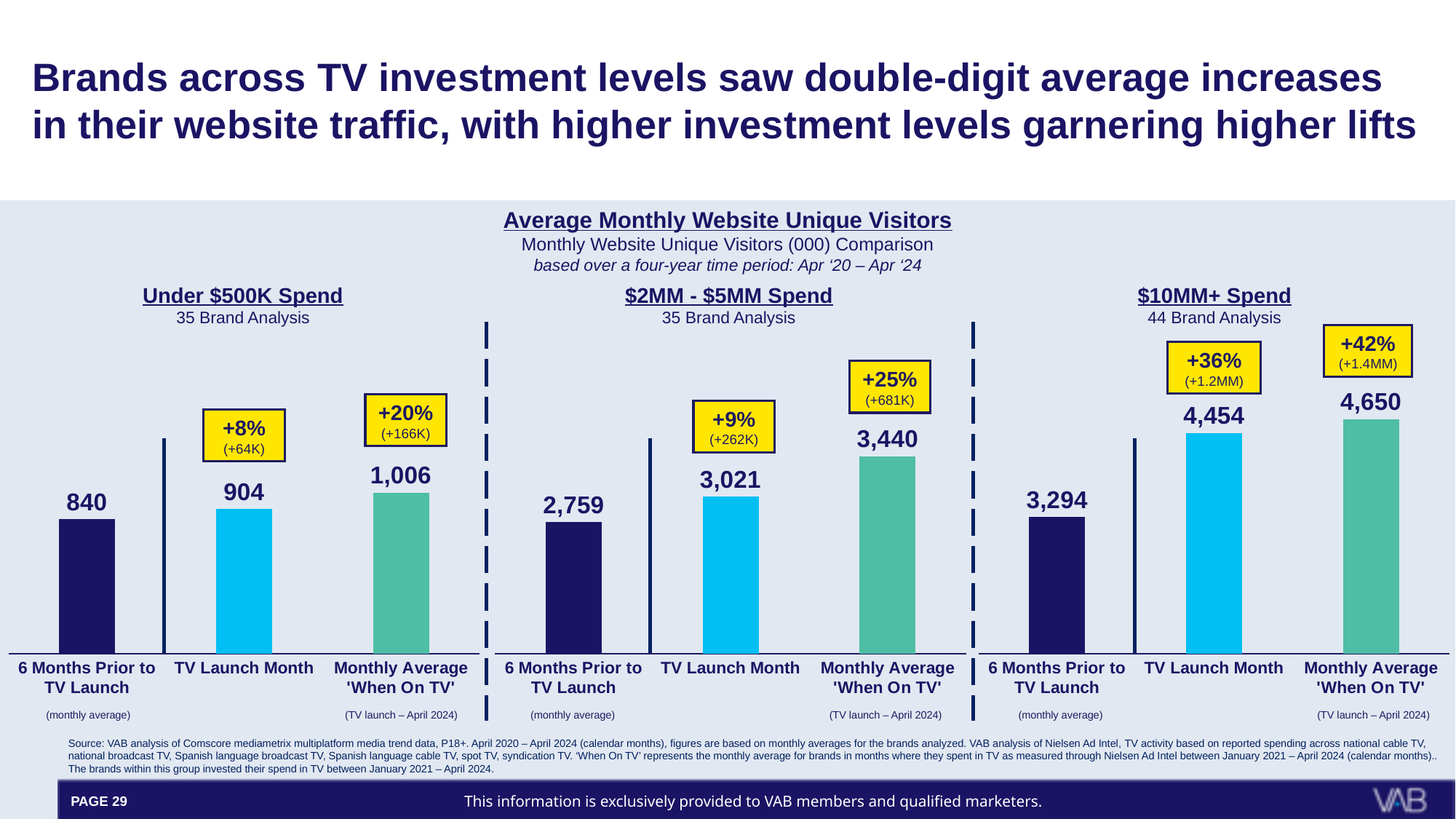
In the '$10MM+ Spend' chart, what is the difference between 'Monthly Average When On TV' and 'TV Launch Month'? 196 In the '$10MM+ Spend' chart, do the values rise or fall from left to right? Rise In the '$2MM - $5MM Spend' chart, what is the value for 'TV Launch Month'? 3,021 In the 'Under $500K Spend' chart, what is the value for '6 Months Prior to TV Launch'? 840 What type of chart is used for the 'Under $500K Spend' data? Bar chart In the 'Under $500K Spend' chart, what is the value for 'Monthly Average When On TV'? 1,006 In the '$2MM - $5MM Spend' chart, which category has the highest value? Monthly Average 'When On TV' In the '$10MM+ Spend' chart, what is the value for 'Monthly Average When On TV'? 4,650 In the 'Under $500K Spend' chart, what is the difference between 'TV Launch Month' and '6 Months Prior to TV Launch'? 64 In the '$10MM+ Spend' chart, which category has the lowest value? 6 Months Prior to TV Launch How many bars are in the '$2MM - $5MM Spend' chart? 3 Which is larger: 'TV Launch Month' in the '$2MM - $5MM Spend' chart or '6 Months Prior to TV Launch' in the '$10MM+ Spend' chart? 6 Months Prior to TV Launch in the $10MM+ Spend chart